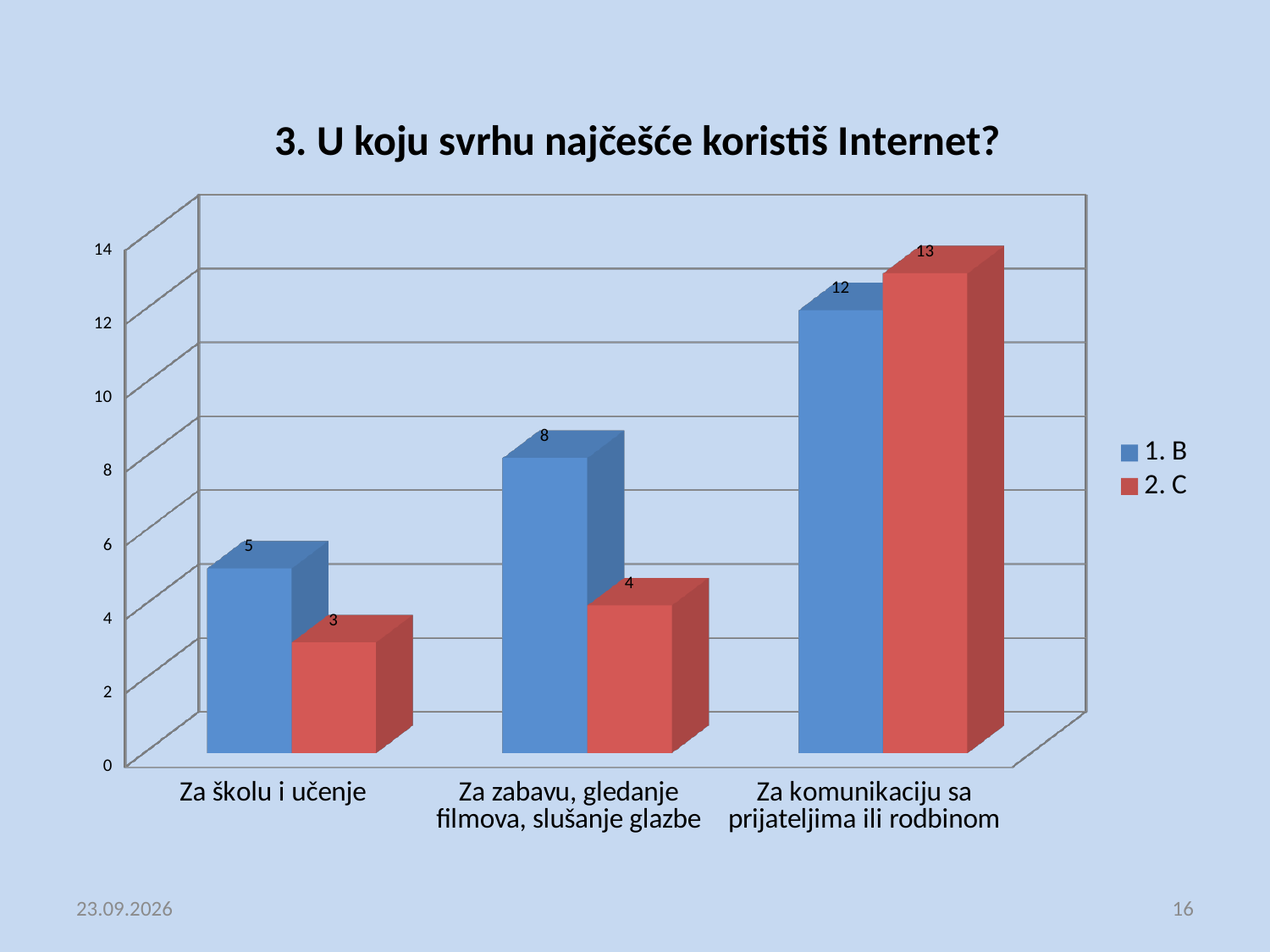
How many categories are shown on the x axis? 3 What is the value for "2. C" in the "Za komunikaciju sa prijateljima ili rodbinom" category? 13 In the "Za komunikaciju sa prijateljima ili rodbinom" category, which series has the larger value, "1. B" or "2. C"? 2. C Which category has the highest value for the "1. B" series? Za komunikaciju sa prijateljima ili rodbinom What is the difference between the "1. B" and "2. C" values in the "Za zabavu, gledanje filmova, slušanje glazbe" category? 4 Which colour represents the "2. C" series in the legend? Red What kind of chart is shown on the slide? Bar chart Which category has the lowest value for the "2. C" series? Za školu i učenje How many series does the legend list? 2 What is the value for "1. B" in the "Za školu i učenje" category? 5 What is the value for "2. C" in the "Za zabavu, gledanje filmova, slušanje glazbe" category? 4 What is the title of the chart? 3. U koju svrhu najčešće koristiš Internet?